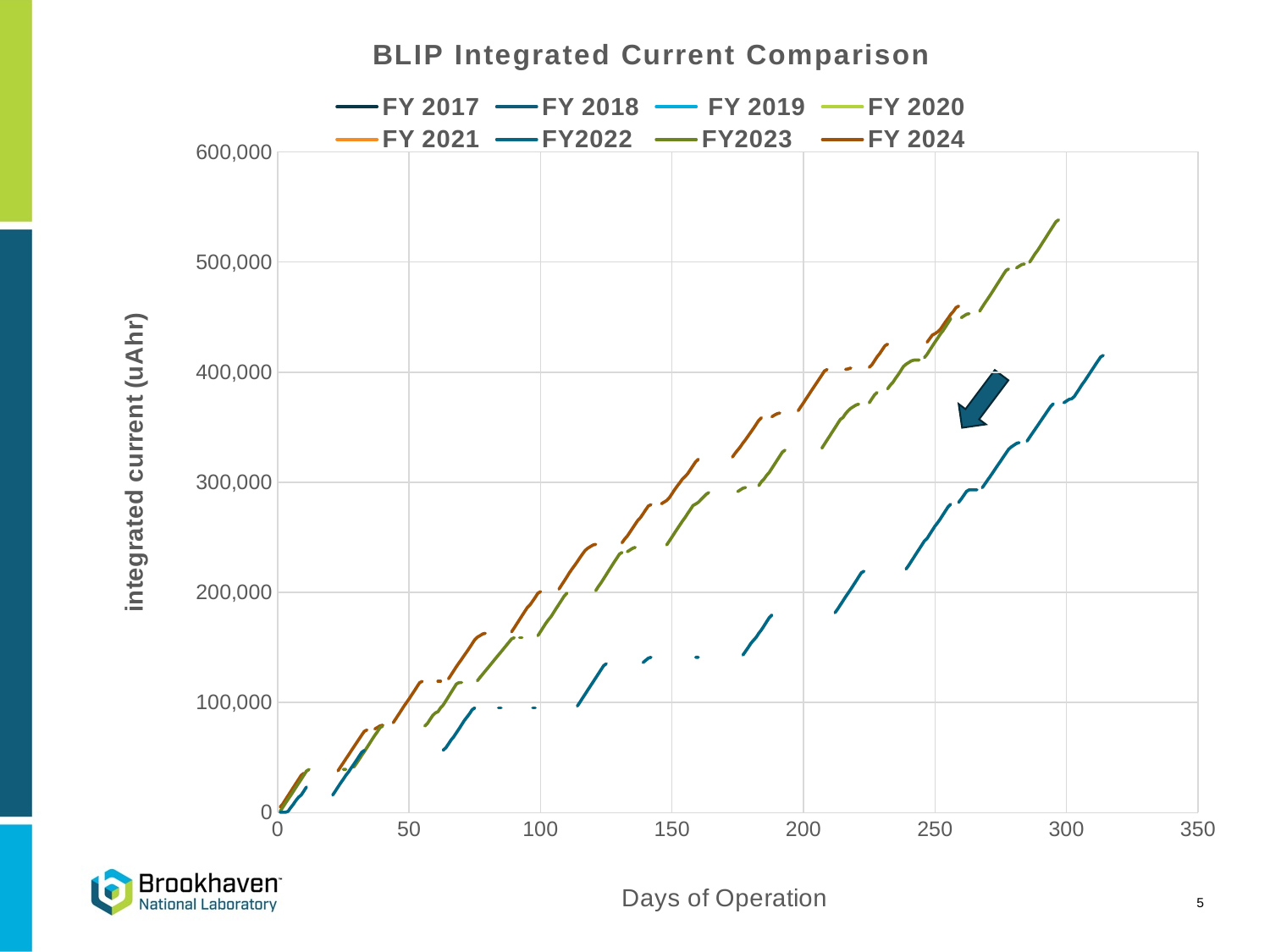
Is the value for FY2023 at 300 days of operation greater or less than 500,000? greater Is the value for FY2022 at 300 days of operation greater or less than 400,000? less Is the value for FY2022 at 200 days of operation greater or less than 200,000? less What is the title of the chart? BLIP Integrated Current Comparison Which series reaches the highest integrated current on the chart? FY2023 At 250 days of operation, which series has the larger integrated current, FY2022 or FY2023? FY2023 How many series does the legend list? 8 What is the label of the y axis? integrated current (uAhr) Do the plotted values rise or fall as Days of Operation increases? Rise What kind of chart is shown on the slide? Line chart